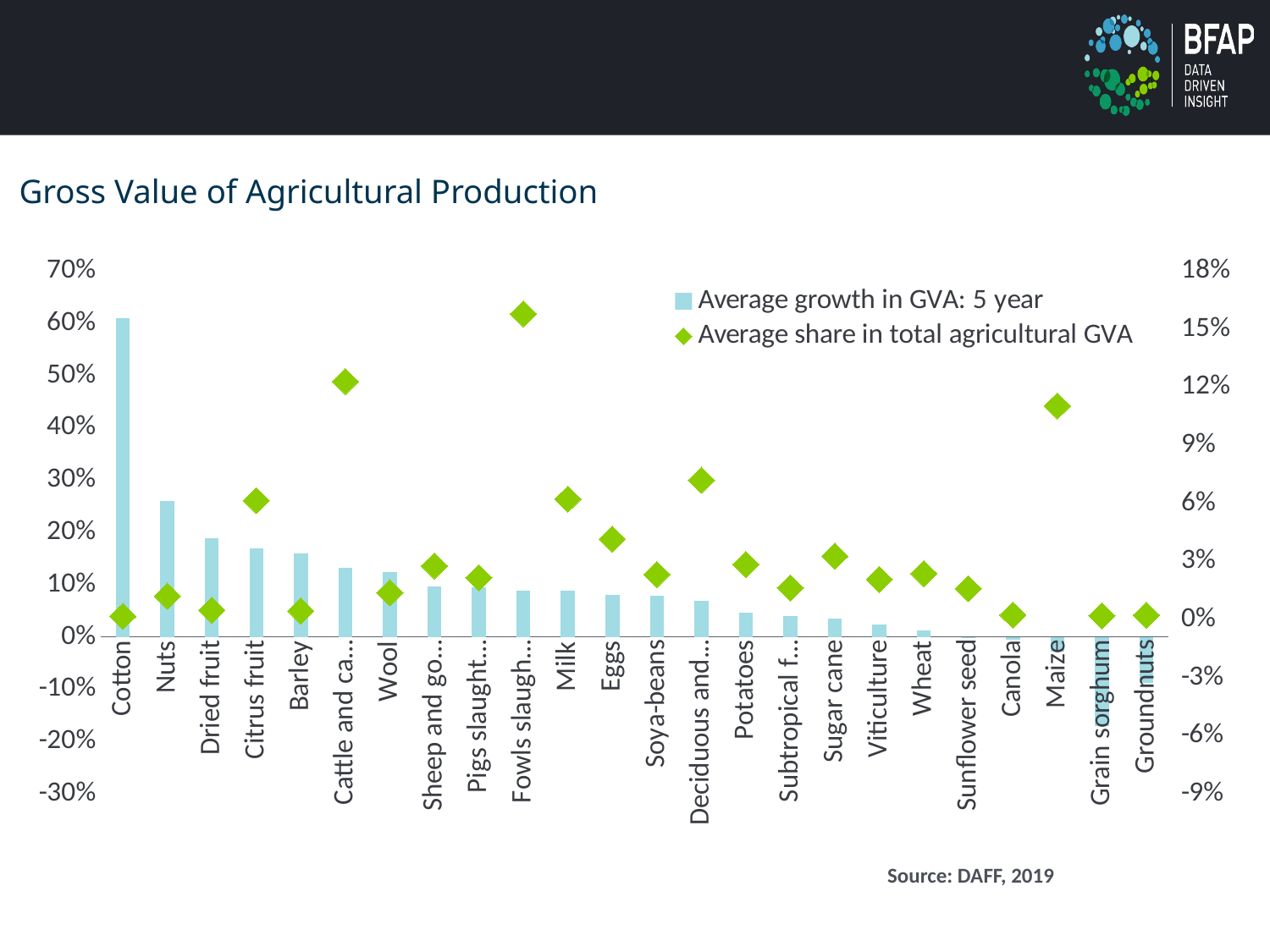
What kind of chart is shown on the slide? A bar chart combined with diamond markers (combo chart) Which category has the highest average share in total agricultural GVA? Fowls slaughtered What is the title of the chart? Gross Value of Agricultural Production Is the average growth in GVA for Cotton greater or less than 50%? greater Is the average growth in GVA for Nuts greater or less than 20%? greater How many series does the legend list? 2 Which category has the highest average growth in GVA (tallest bar)? Cotton How many categories are shown on the x axis? 24 Is the average share in total agricultural GVA for Cotton greater or less than 3%? less Which has a higher average growth in GVA, Cotton or Nuts? Cotton Do the average growth in GVA bars generally rise or fall from left to right along the x axis? fall